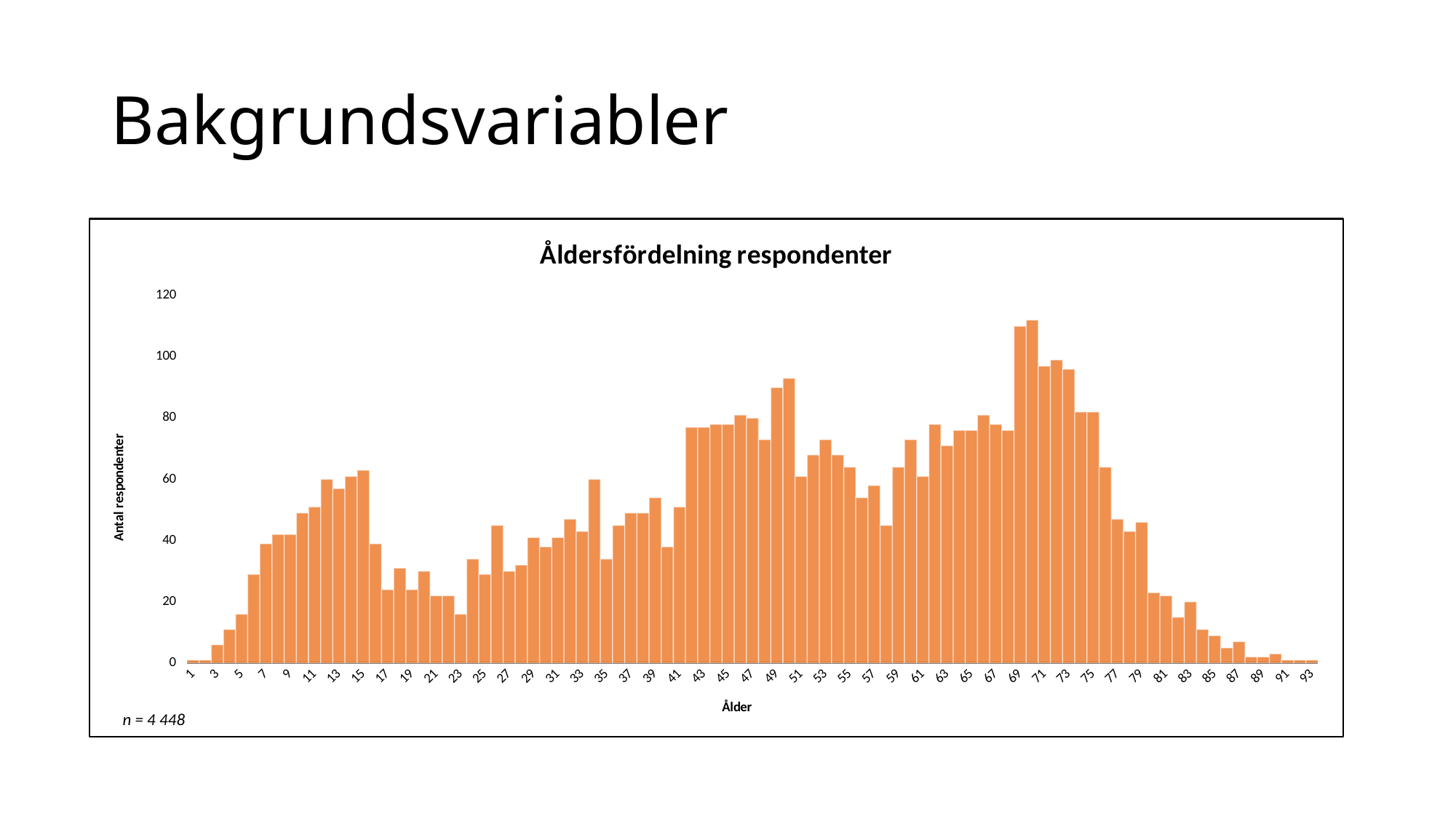
What kind of chart is shown on the slide? bar chart Is the value for age 75 greater or less than 60? greater What is the title of the chart? Åldersfördelning respondenter Which has the larger value, age 70 or age 23? age 70 Which has the larger value, age 20 or age 50? age 50 Is the value for age 23 greater or less than 20? less Is the value for age 87 greater or less than 20? less What is the label on the vertical axis of the chart? Antal respondenter Do the values rise or fall along the x axis from age 77 to age 93? fall